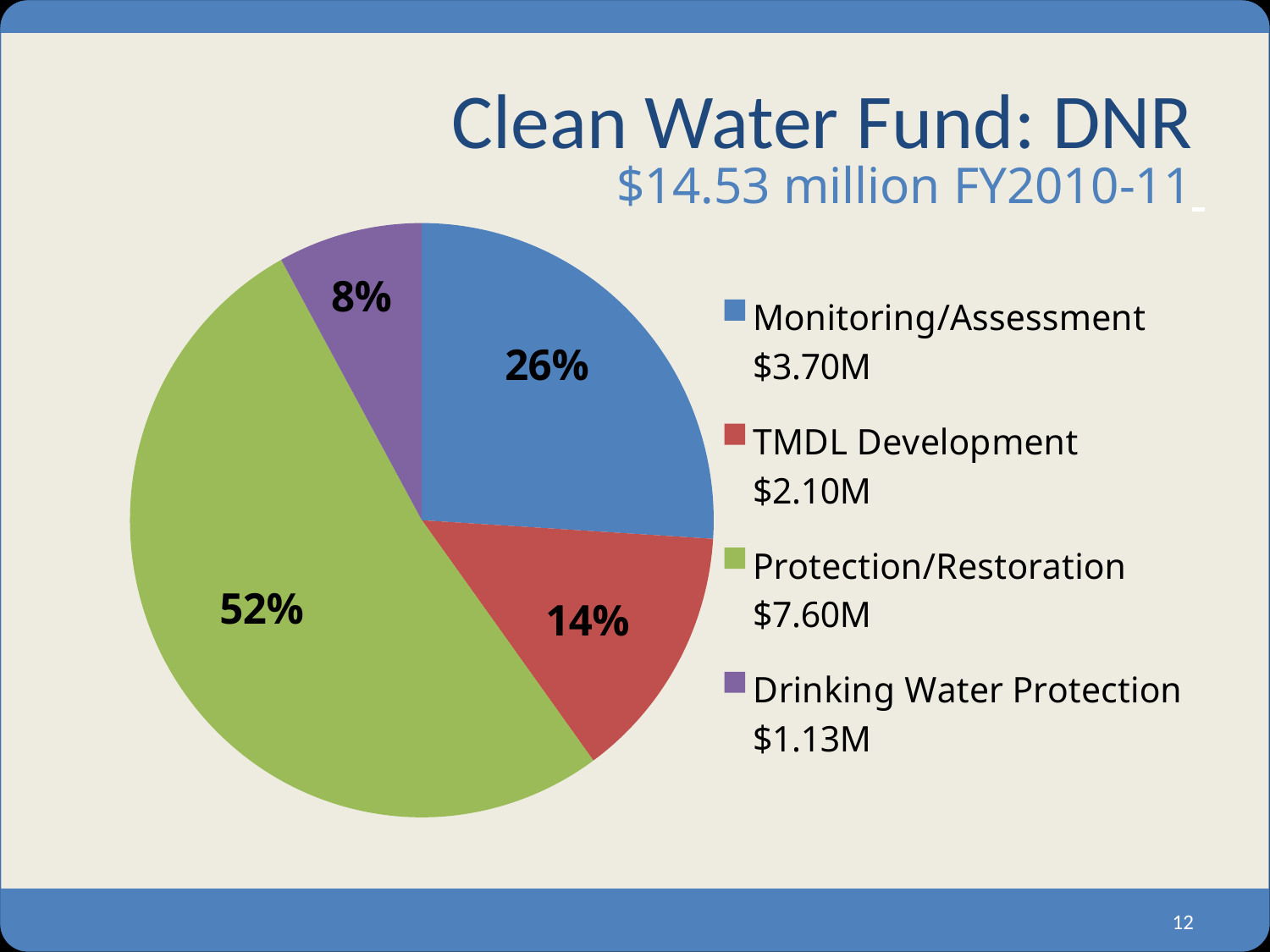
What colour is the Protection/Restoration slice in the pie chart? green What percentage share does TMDL Development have in the pie chart? 14% How many categories does the pie chart show? 4 What percentage share does Protection/Restoration have in the pie chart? 52% Which slice is larger, TMDL Development or Drinking Water Protection? TMDL Development What type of chart is shown on the slide? pie chart What is the difference in percentage points between the Protection/Restoration and Monitoring/Assessment slices? 26 Which category has the smallest slice of the pie chart? Drinking Water Protection What percentage share does Monitoring/Assessment have in the pie chart? 26% What dollar amount does the legend give for TMDL Development? $2.10M Which category has the largest slice of the pie chart? Protection/Restoration